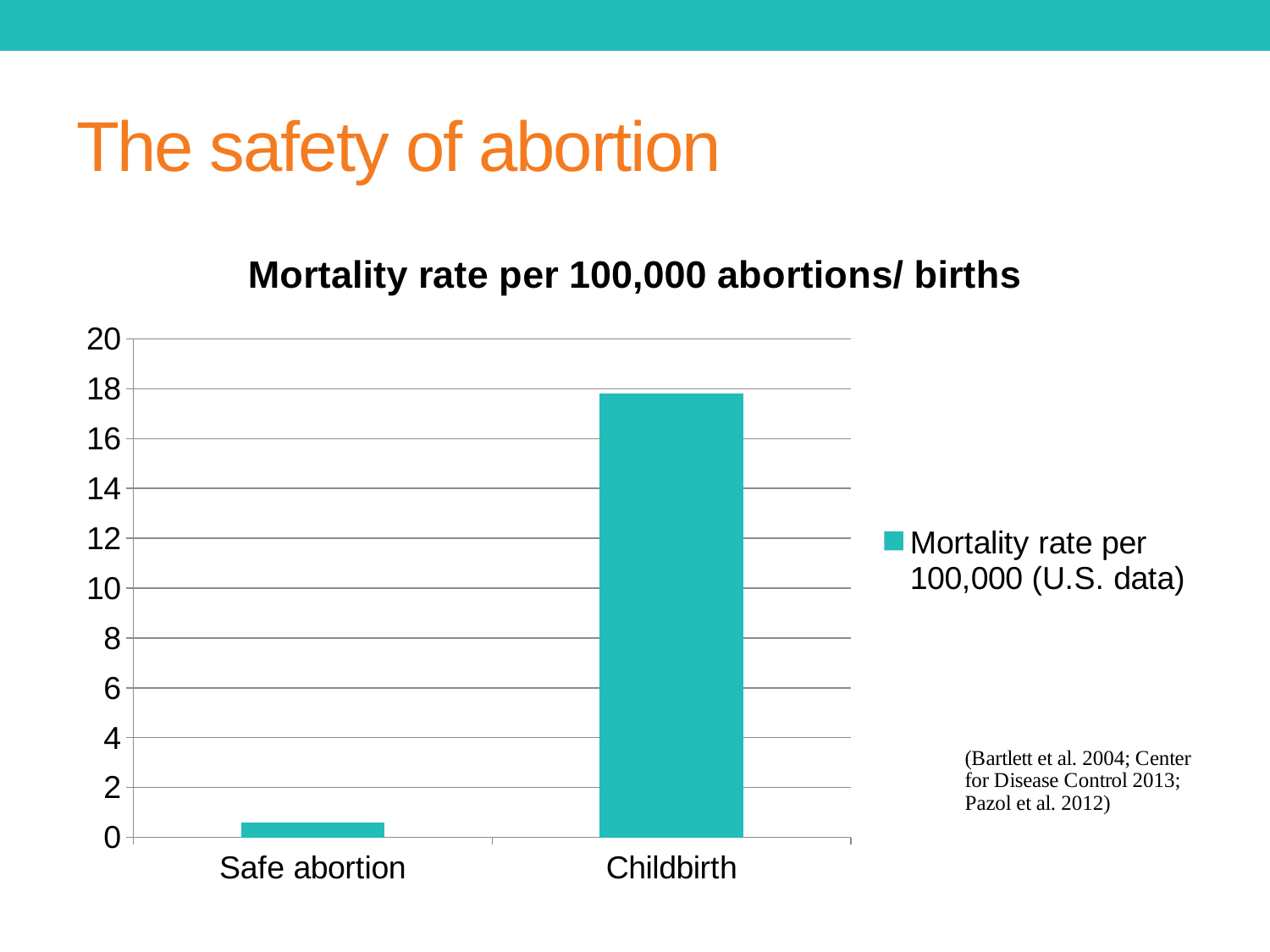
Is the value for Childbirth greater or less than 16? greater Which category has the lowest mortality rate in the chart? Safe abortion What is the title of the chart? Mortality rate per 100,000 abortions/ births How many categories are shown on the x axis of the chart? 2 Which category has the highest mortality rate in the chart? Childbirth How many series does the chart's legend list? 1 What kind of chart is shown on the slide? bar chart What is the legend entry for the series in the chart? Mortality rate per 100,000 (U.S. data) Which has a larger value in the chart, Safe abortion or Childbirth? Childbirth Is the value for Safe abortion greater or less than 2? less